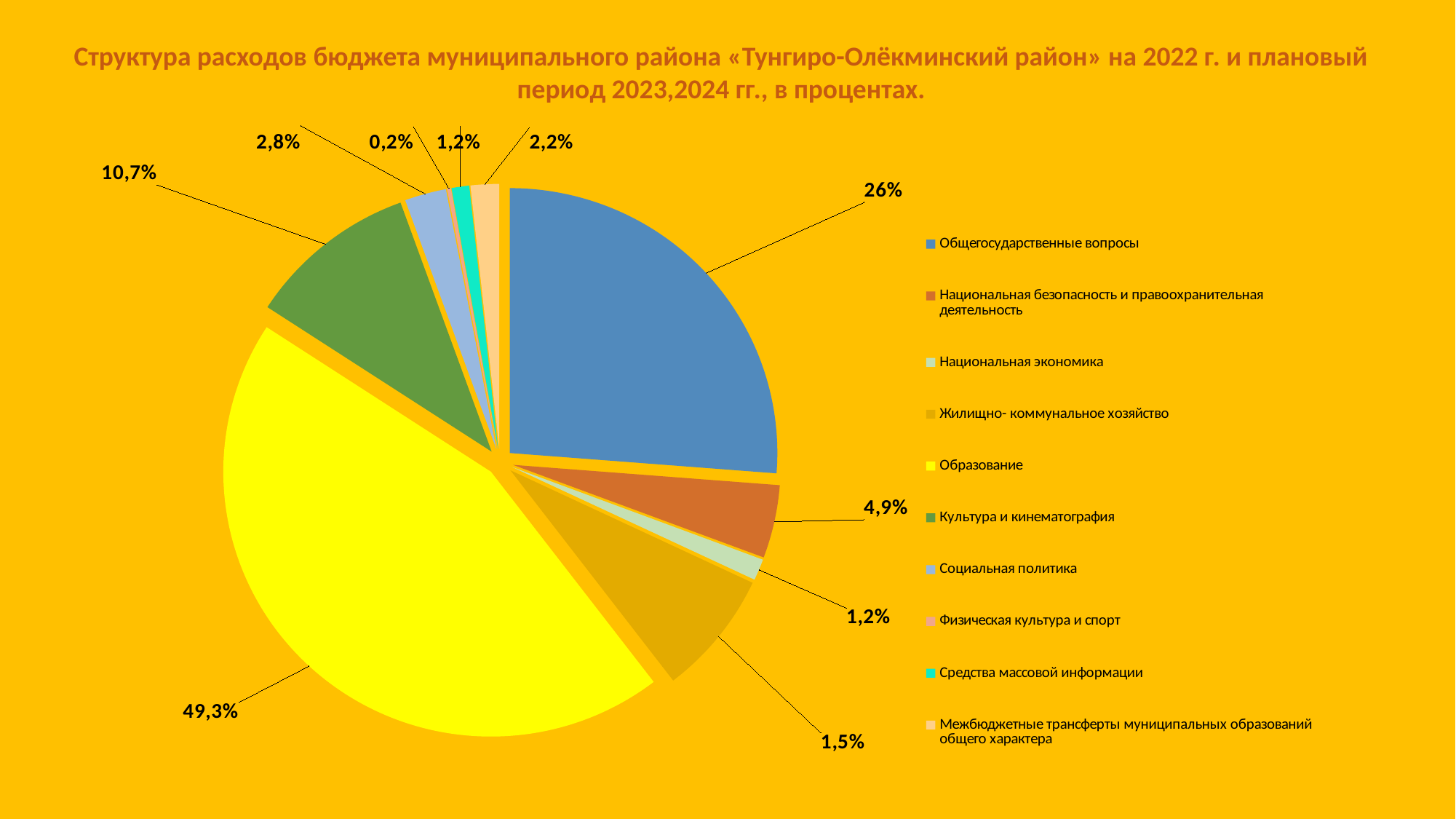
Which is larger: the share of Культура и кинематография or the share of Национальная безопасность и правоохранительная деятельность? Культура и кинематография What is the difference between the shares of Образование and Общегосударственные вопросы? 23,3% How many categories does the pie chart show? 10 What colour is the slice for Образование? yellow What share of the budget expenditure goes to Культура и кинематография? 10,7% Which category has the smallest share of the budget expenditure? Физическая культура и спорт What share of the budget expenditure goes to Общегосударственные вопросы? 26% What kind of chart is shown on the slide? pie chart Which category has the largest share of the budget expenditure? Образование What share of the budget expenditure goes to Социальная политика? 2,8% What share of the budget expenditure goes to Образование? 49,3% What share of the budget expenditure goes to Национальная безопасность и правоохранительная деятельность? 4,9%